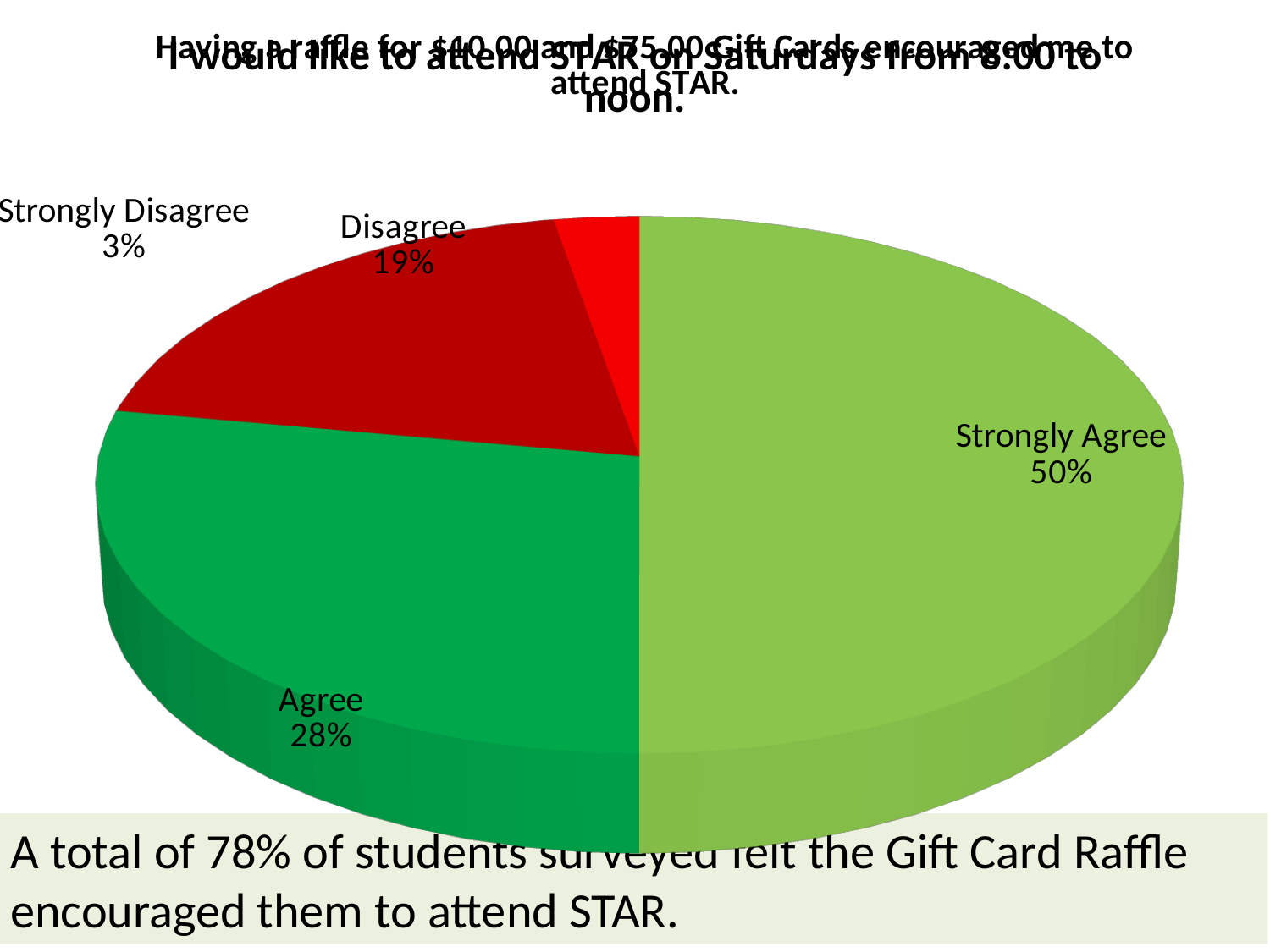
What percentage of respondents chose Strongly Agree? 50% Which is larger, the Agree slice or the Disagree slice? Agree What percentage of respondents chose Disagree? 19% How many slices does the pie chart have? 4 Which response category has the smallest share of the pie? Strongly Disagree What percentage of respondents chose Strongly Disagree? 3% What colour is the Strongly Agree slice? light green What percentage of respondents chose Agree? 28% What kind of chart is shown on the slide? pie chart What is the combined share of Strongly Agree and Agree? 78% What is the difference in percentage points between Strongly Agree and Agree? 22 Which response category has the largest share of the pie? Strongly Agree